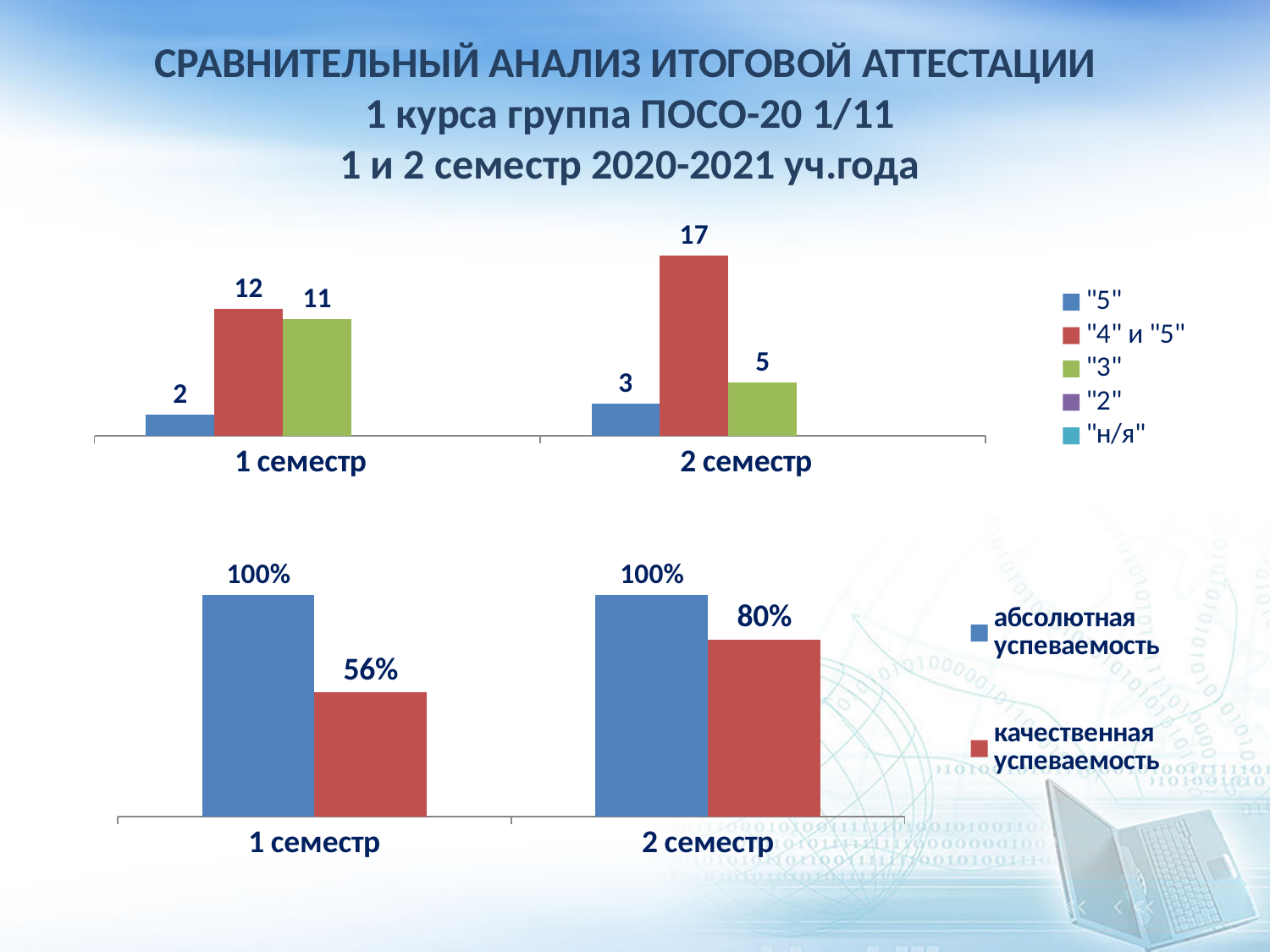
How many series does the legend of the top chart list? 5 In the top chart, what is the value for "4" и "5" in 2 семестр? 17 What kind of chart is the bottom chart? bar chart In the top chart, is the value for "3" larger in 1 семестр or 2 семестр? 1 семестр In the bottom chart, what is the difference between качественная успеваемость in 2 семестр and 1 семестр? 24% In the top chart, which series has the highest value in 2 семестр? "4" и "5" In the top chart, what is the value for "5" in 2 семестр? 3 In the top chart, what is the difference between the "4" и "5" values for 2 семестр and 1 семестр? 5 In the bottom chart, what is the value for абсолютная успеваемость in 2 семестр? 100% In the top chart, what is the value for "3" in 1 семестр? 11 In the bottom chart, what is the value for качественная успеваемость in 1 семестр? 56%